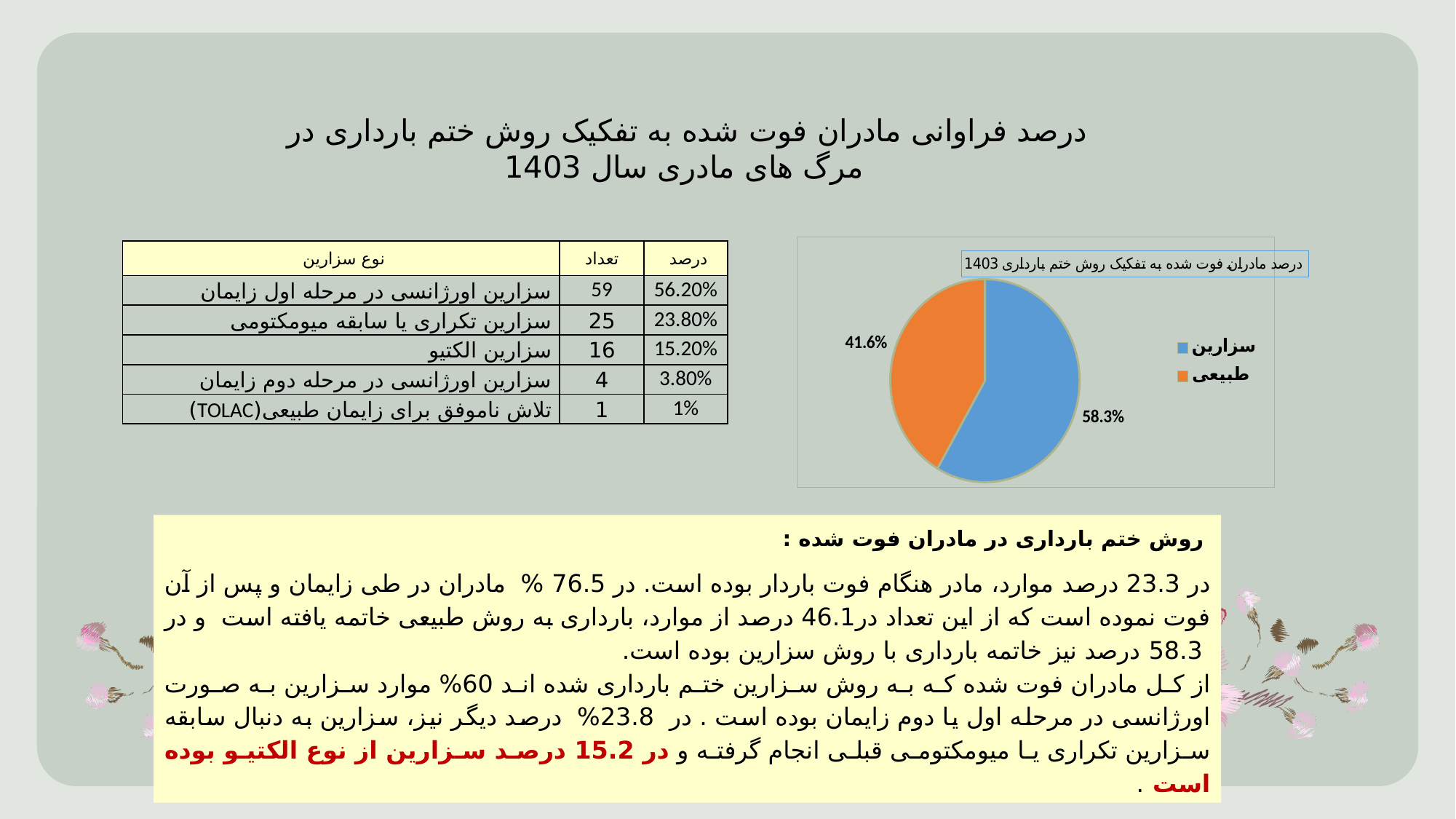
How many slices does the pie chart have? 2 How many entries does the pie chart's legend list? 2 What colour is the طبیعی slice in the pie chart? orange Which slice of the pie chart is the smallest? طبیعی What percentage does the pie chart show for طبیعی? 41.6% What percentage does the pie chart show for سزارین? 58.3% What kind of chart is shown on the slide? pie chart Which slice of the pie chart is the largest? سزارین Which is larger in the pie chart, سزارین or طبیعی? سزارین What is the difference between the سزارین and طبیعی shares in the pie chart? 16.7% What colour is the سزارین slice in the pie chart? blue